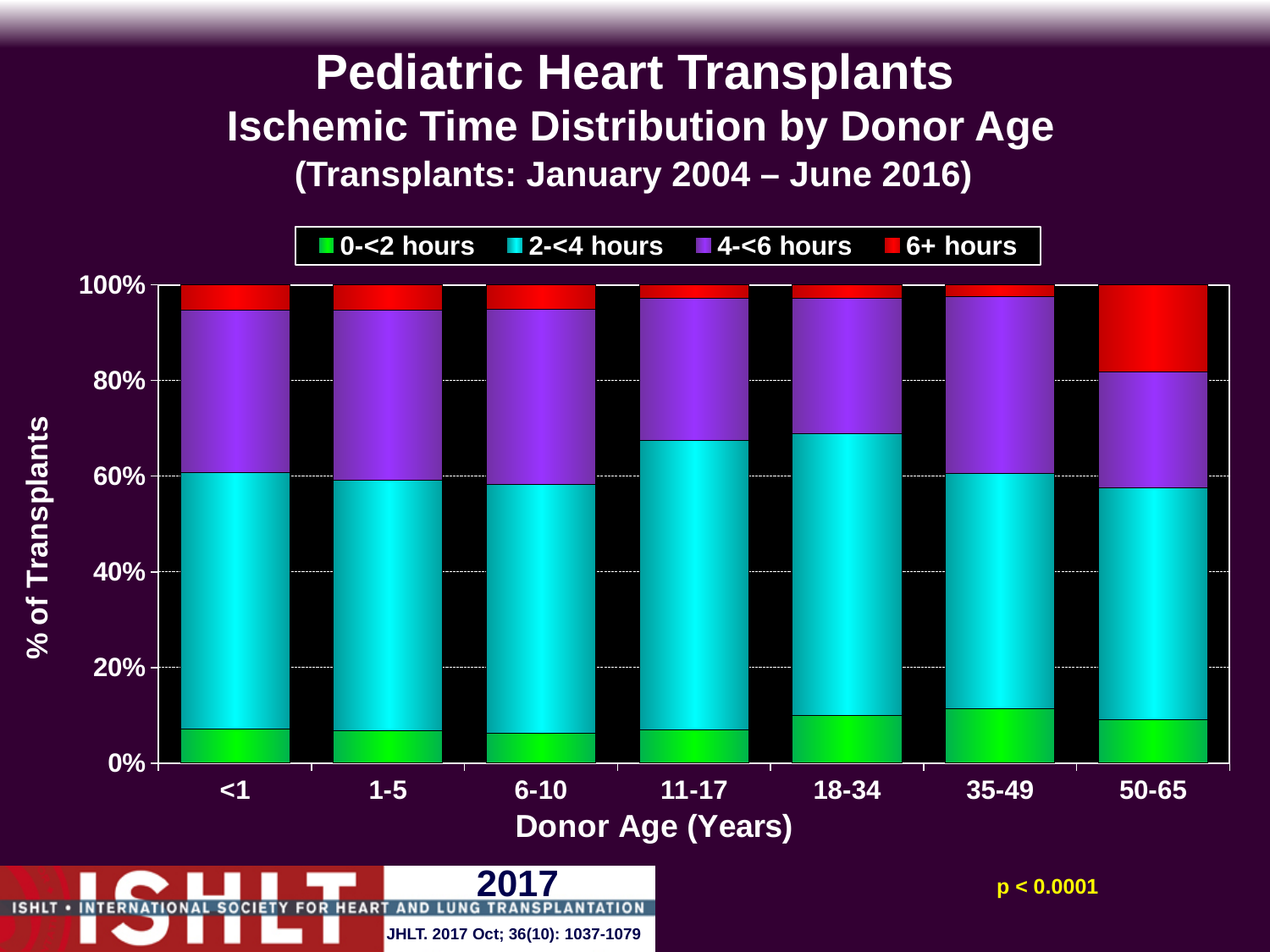
Is the 0-<2 hours share for the <1 donor age group greater or less than 20%? less Is the 2-<4 hours share for the 18-34 donor age group greater or less than 40%? greater Is the 2-<4 hours segment larger for the 11-17 or the 6-10 donor age group? 11-17 Is the 0-<2 hours segment larger for the 35-49 or the 6-10 donor age group? 35-49 What is the title of the x axis? Donor Age (Years) Is the 6+ hours share for the 50-65 donor age group greater or less than 10%? greater Is the 4-<6 hours segment larger for the <1 or the 50-65 donor age group? <1 What kind of chart is shown on the slide? Stacked bar chart How many donor age groups are shown on the x axis? 7 How many series does the legend list? 4 Which donor age group has the largest share of transplants with 6+ hours ischemic time? 50-65 What is the total of the stacked bar for the <1 donor age group? 100%